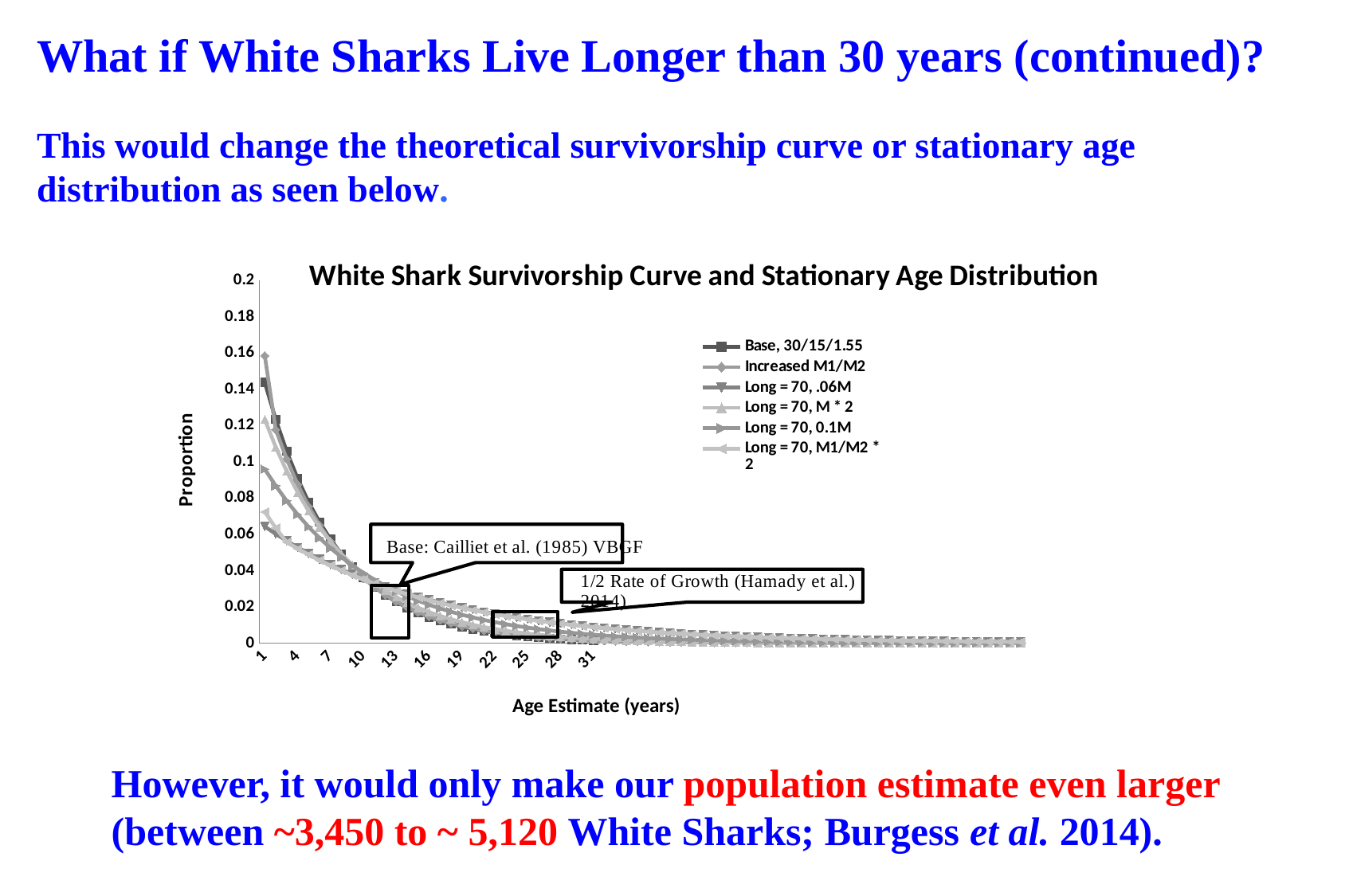
What is the title of the chart? White Shark Survivorship Curve and Stationary Age Distribution What is the label of the x axis of the chart? Age Estimate (years) Is the value for the Increased M1/M2 series at age 1 greater or less than 0.14? greater How many series does the legend of the chart list? 6 At age 1, which is larger: the Increased M1/M2 series or the Base, 30/15/1.55 series? Increased M1/M2 What is the highest value shown on the y axis of the chart? 0.2 Which series has the highest value at age 1? Increased M1/M2 Do the plotted proportions rise or fall as age estimate increases? fall Is the value for the Long = 70, .06M series at age 1 greater or less than 0.08? less Is the value for the Base, 30/15/1.55 series at age 1 greater or less than 0.12? greater What kind of chart is shown on the slide? line chart